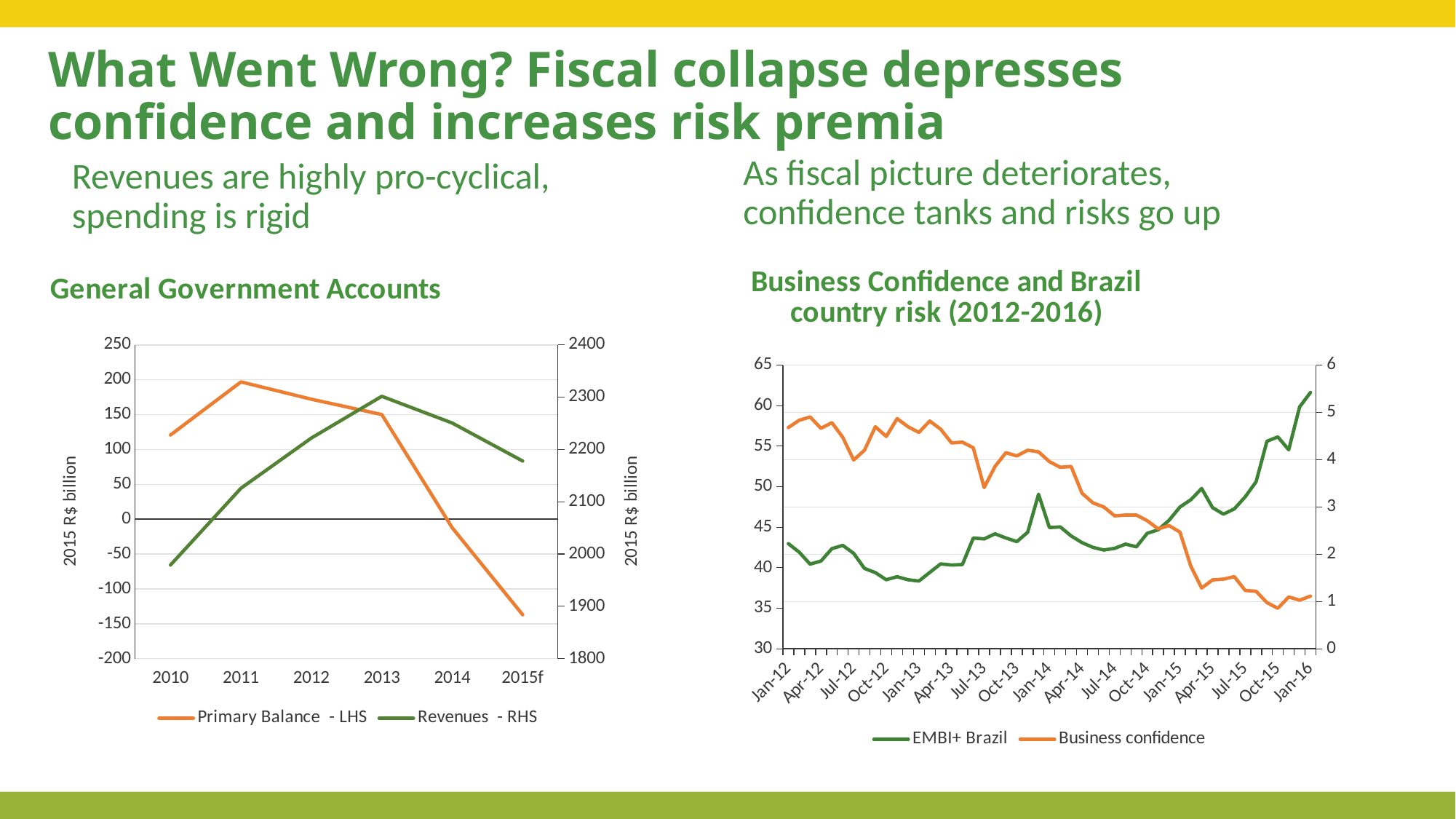
On the General Government Accounts chart, how many series does the legend list? 2 On the General Government Accounts chart, in which year is the Primary Balance lowest? 2015f On the General Government Accounts chart, in which year are Revenues highest? 2013 On the General Government Accounts chart, which year has the larger Primary Balance, 2010 or 2013? 2013 On the General Government Accounts chart, how many years are shown on the x axis? 6 On the Business Confidence and Brazil country risk chart, how many series does the legend list? 2 On the Business Confidence and Brazil country risk chart, does Business confidence rise or fall overall from Jan-12 to Jan-16? fall On the General Government Accounts chart, is the Revenues value for 2013 greater or less than 2200? greater On the General Government Accounts chart, what kind of chart is it? line chart On the General Government Accounts chart, is the Primary Balance for 2015f greater or less than -100? less On the General Government Accounts chart, in which year is the Primary Balance highest? 2011 On the Business Confidence and Brazil country risk chart, is the EMBI+ Brazil value at Jan-16 greater or less than 5? greater